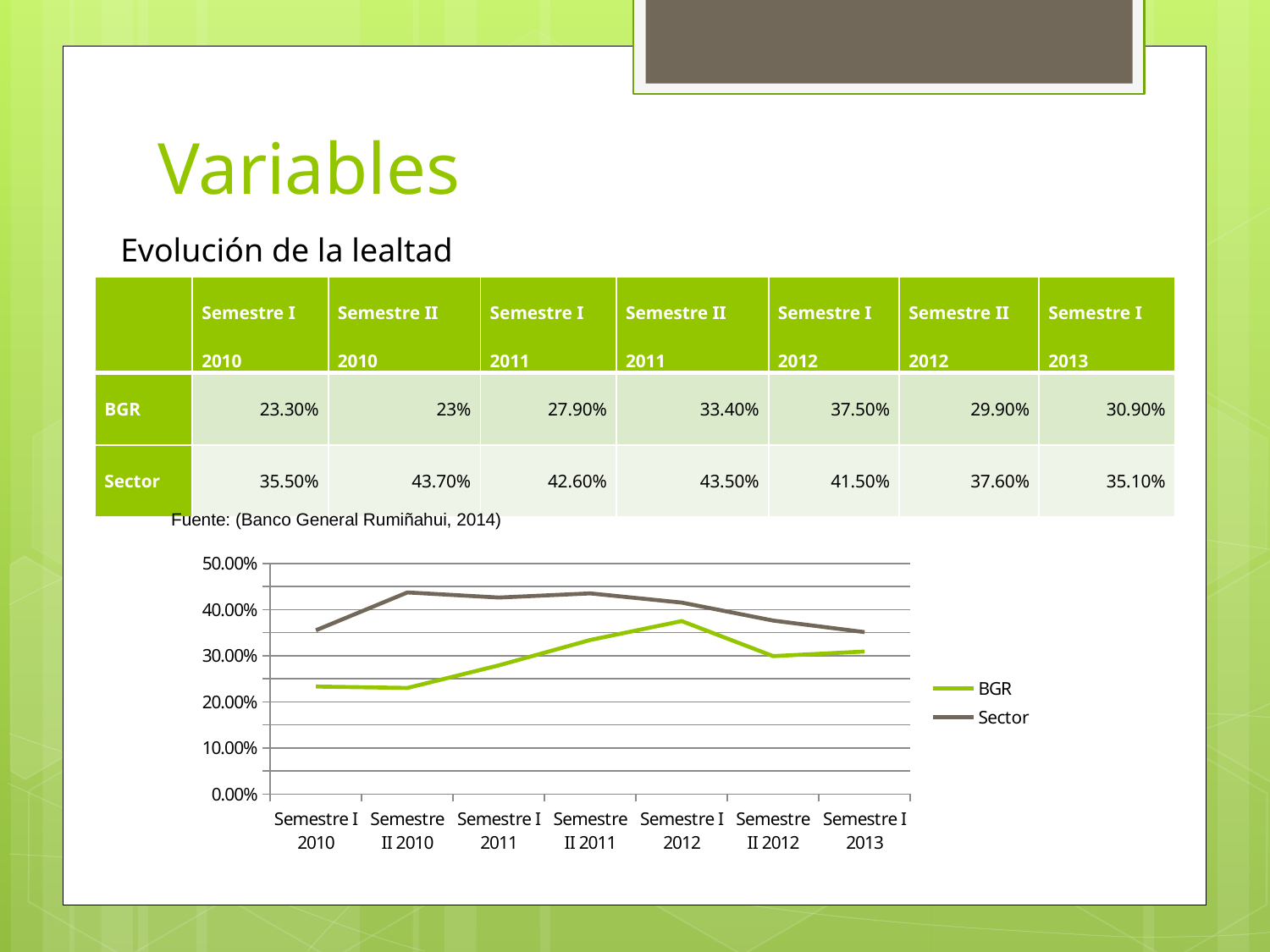
What is the Sector value for Semestre II 2010? 43.70% How many series does the chart legend list? 2 What is the BGR value for Semestre I 2013? 30.90% Is the Sector value for Semestre II 2010 greater or less than 40.00%? greater What type of chart is shown on the slide? Line chart What is the difference between the BGR values for Semestre I 2012 and Semestre I 2010? 14.20% Does the Sector series rise or fall from Semestre II 2011 to Semestre I 2013? Fall How many semesters are plotted along the x axis of the chart? 7 In which semester does the BGR series reach its highest value? Semestre I 2012 What is the BGR value for Semestre I 2012? 37.50% Which series is higher in Semestre I 2010, BGR or Sector? Sector Is the BGR value for Semestre I 2011 greater or less than 30.00%? less